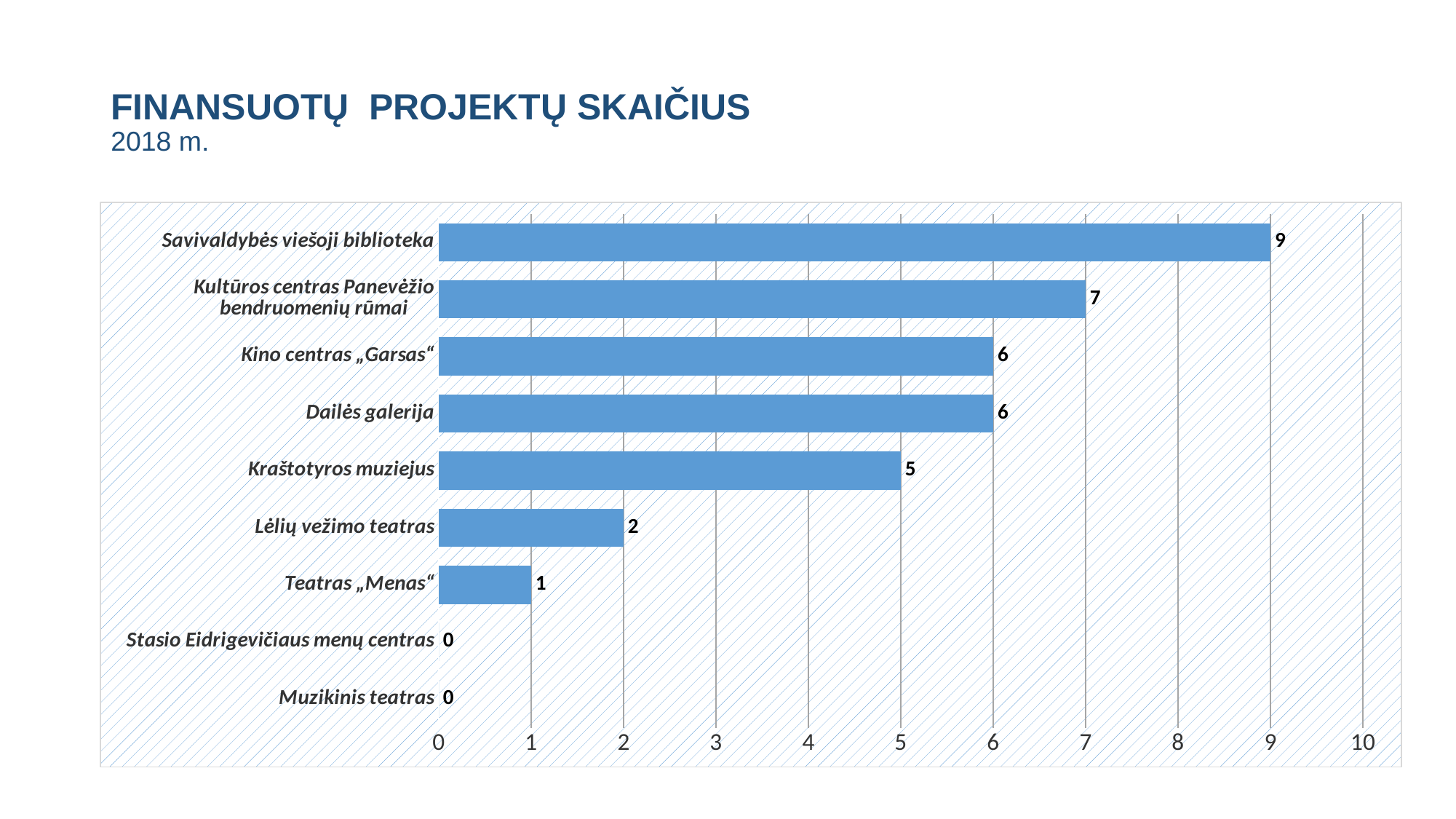
What is the value for Kraštotyros muziejus? 5 How many categories have a value of 0? 2 What is the value for Dailės galerija? 6 Which category has the highest value? Savivaldybės viešoji biblioteka What is the difference between the values for Savivaldybės viešoji biblioteka and Kino centras „Garsas“? 3 What kind of chart is shown on the slide? bar chart What is the value for Teatras „Menas“? 1 Which is larger, the value for Kraštotyros muziejus or the value for Lėlių vežimo teatras? Kraštotyros muziejus What is the value for Savivaldybės viešoji biblioteka? 9 What is the title of the chart on the slide? FINANSUOTŲ PROJEKTŲ SKAIČIUS How many categories are shown on the chart? 9 What is the value for Kultūros centras Panevėžio bendruomenių rūmai? 7